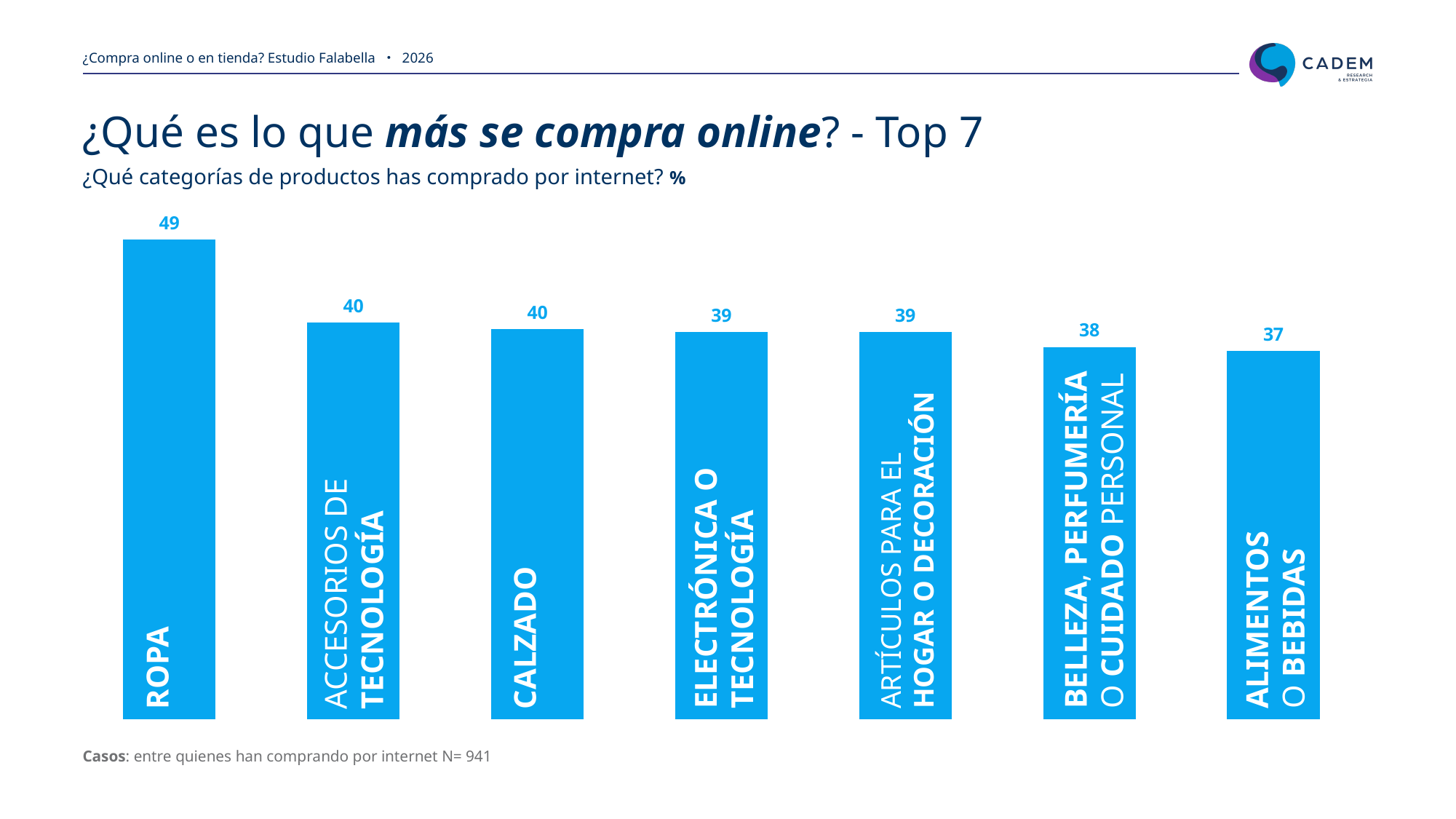
What kind of chart is shown on the slide? Bar chart How many categories are shown in the chart? 7 What is the difference between the values for Ropa and Calzado? 9 Which is larger, the value for Ropa or the value for Artículos para el hogar o decoración? Ropa What is the difference between the values for Electrónica o tecnología and Alimentos o bebidas? 2 Which category has the lowest value? Alimentos o bebidas What is the value for Belleza, perfumería o cuidado personal? 38 What is the value for Alimentos o bebidas? 37 What is the value for Ropa? 49 Do the values rise or fall from left to right across the chart? Fall Which category has the highest value? Ropa What is the value for Calzado? 40